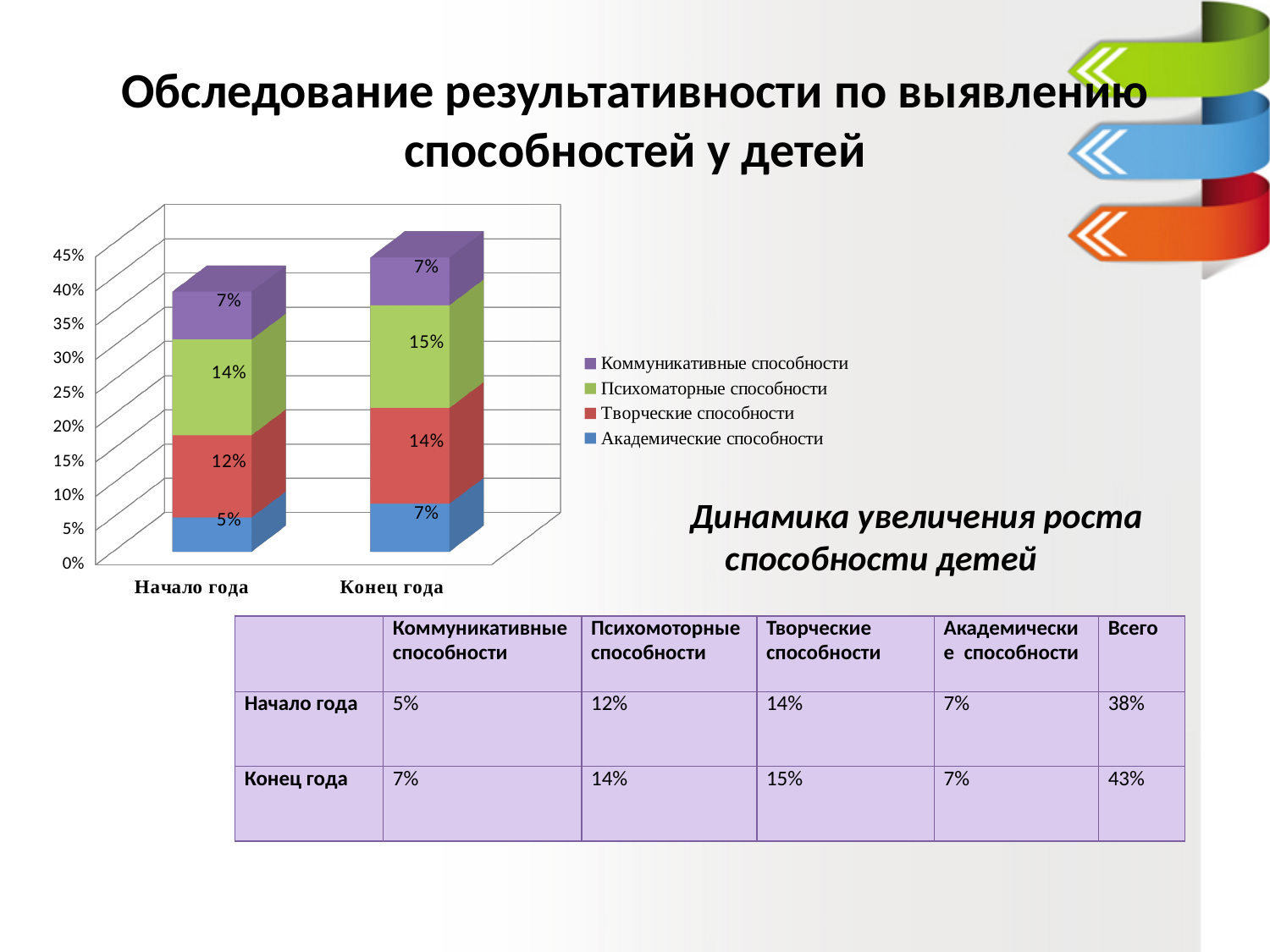
Which stacked bar is taller overall, Начало года or Конец года? Конец года What value is labelled on the red segment of the Начало года bar? 12% How many categories are shown on the x axis of the chart? 2 How many series does the chart legend list? 4 What is the total of the stacked bar for Конец года? 43% What value is labelled on the top (purple) segment of the Конец года bar? 7% What value is labelled on the green segment of the Конец года bar? 15% What kind of chart is shown on the slide? stacked bar chart What is the total of the stacked bar for Начало года? 38% What value is labelled on the bottom (blue) segment of the Начало года bar? 5% What is the first entry listed in the chart legend? Коммуникативные способности By how much does the red segment of Конец года exceed the red segment of Начало года? 2%